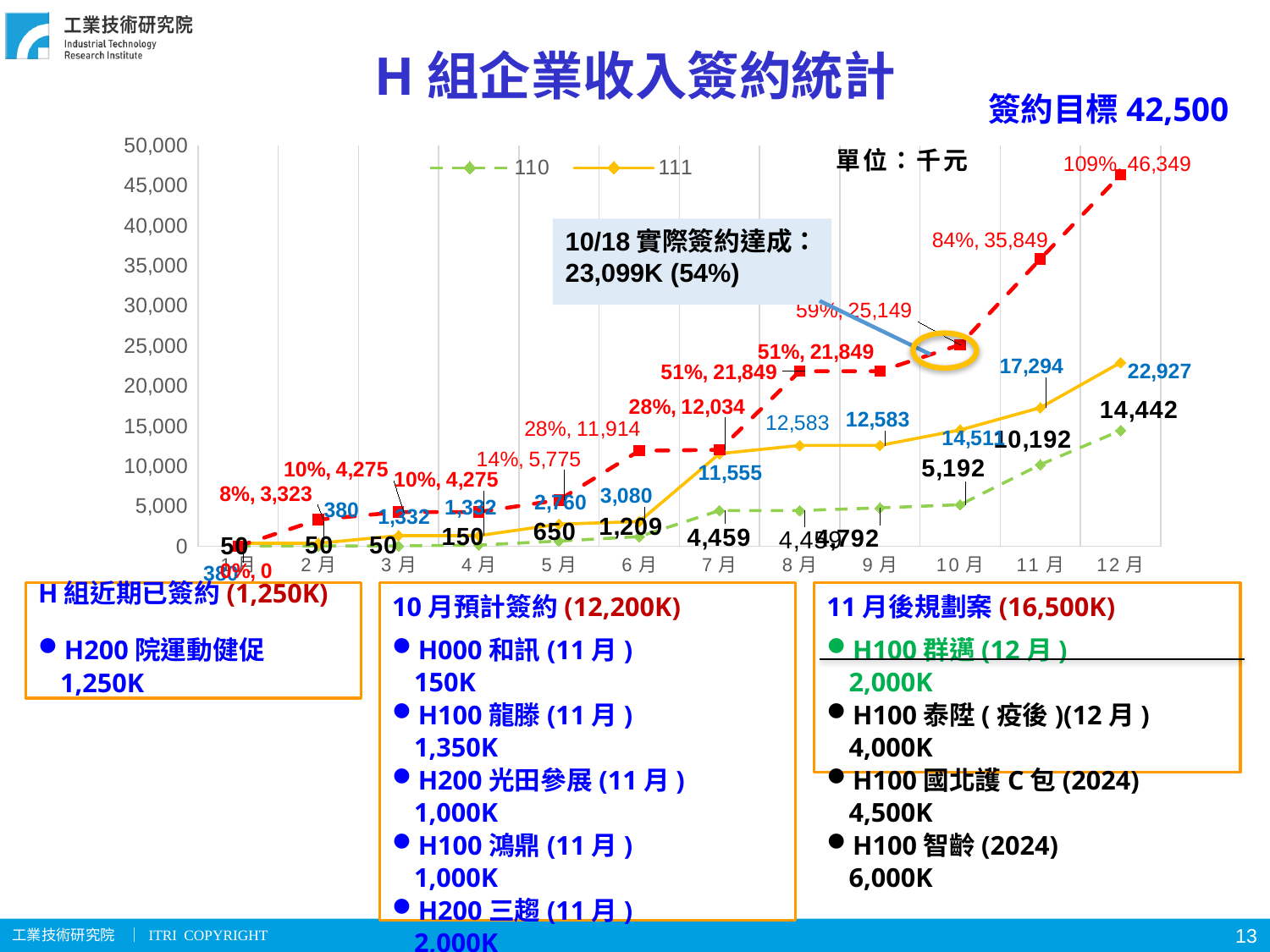
What is the value of the 111 series in 11月? 17,294 What is the value of the 111 series in 12月? 22,927 How many series does the chart legend list? 2 What is the value of the 110 series in 12月? 14,442 What kind of chart is shown on the slide? line chart What is the 簽約目標 stated on the slide? 42,500 What is the difference between the 111 and 110 series values in 12月? 8,485 Does the 111 series generally rise or fall from 1月 to 12月? rise In 11月, which series has the larger value, 110 or 111? 111 How many months are shown on the x axis? 12 In which month does the 111 series reach its highest value? 12月 What is the value of the 110 series in 11月? 10,192